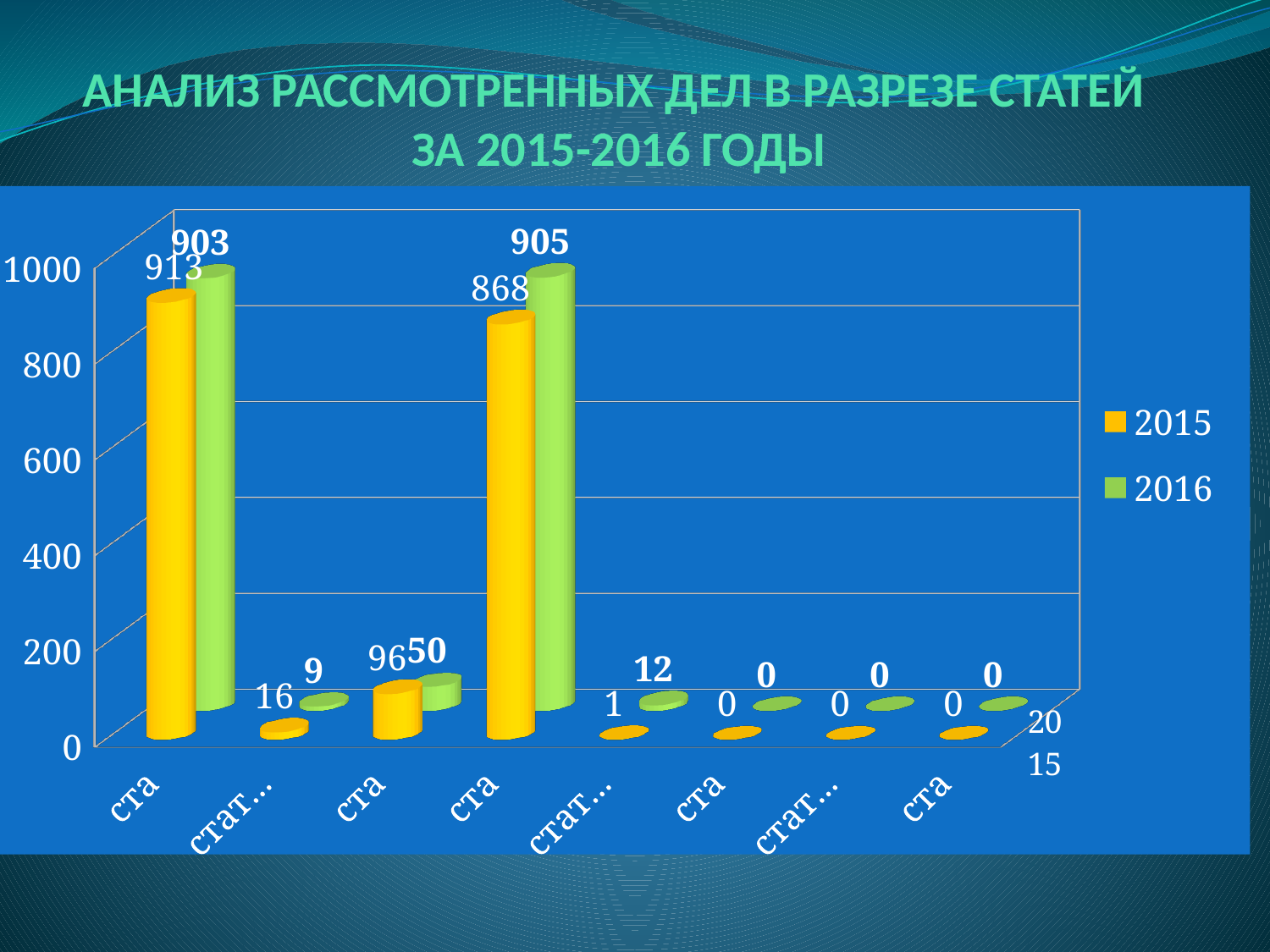
What kind of chart is shown on the slide? bar chart What is the 2015 value for the first category from the left? 913 Which category has the highest 2016 value? the fourth category from the left (905) What is the difference between the 2015 and 2016 values for the fourth category from the left? 37 How many categories are shown along the x axis? 8 What is the difference between the 2015 and 2016 values for the second category from the left? 7 What is the 2016 value for the first category from the left? 903 For the third category from the left, which is larger, the 2015 value or the 2016 value? 2015 Which years are listed in the legend? 2015 and 2016 What is the 2015 value for the third category from the left? 96 What is the 2016 value for the fourth category from the left? 905 How many series does the legend list? 2